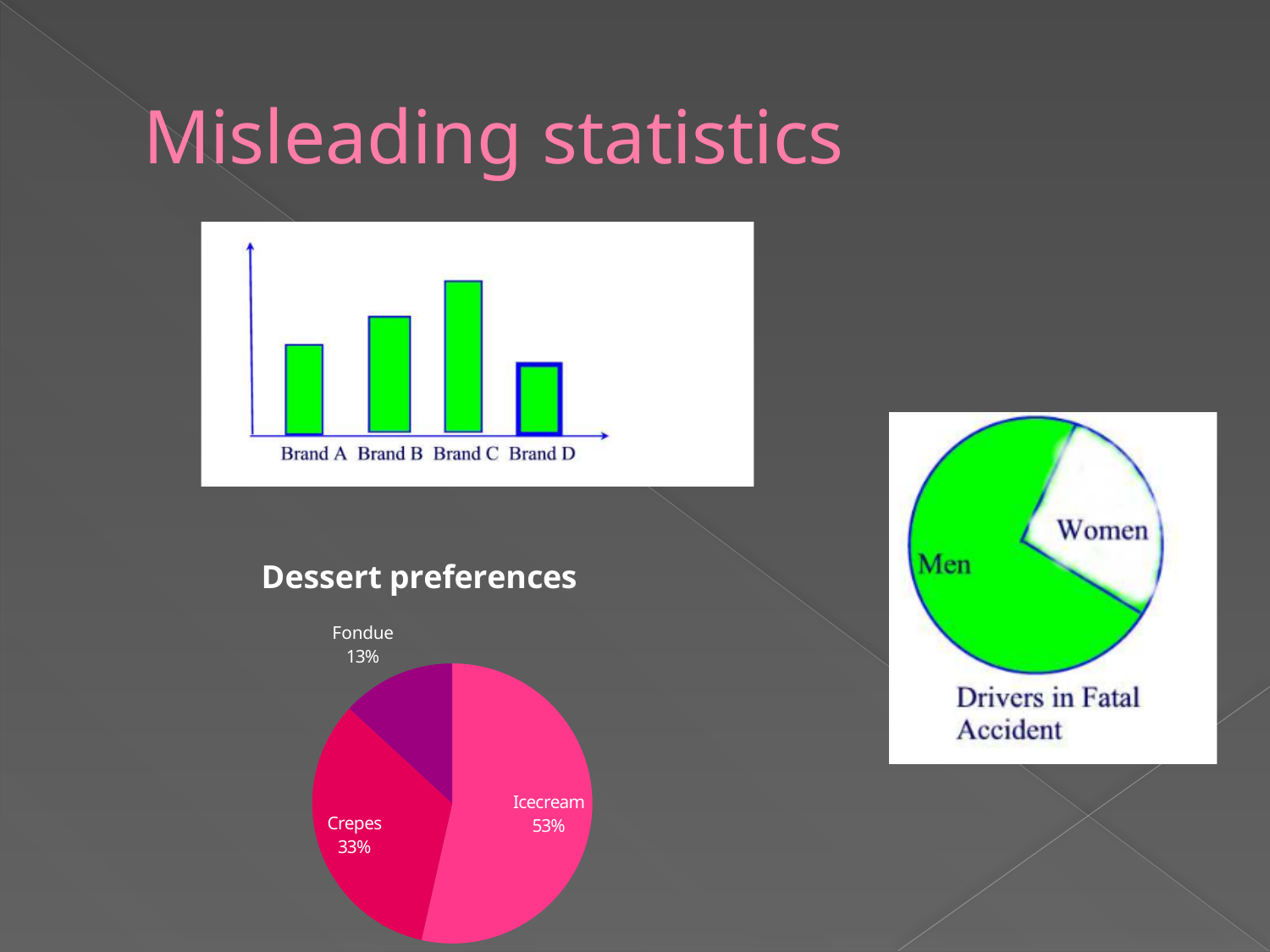
In the Dessert preferences pie chart, what share does Icecream have? 53% In the Dessert preferences pie chart, which dessert has the largest share? Icecream In the bar chart at the top left, which bar is taller, Brand A or Brand B? Brand B In the bar chart at the top left, which brand has the shortest bar? Brand D In the Dessert preferences pie chart, what share does Crepes have? 33% In the bar chart at the top left, how many brands are shown? 4 In the Dessert preferences pie chart, what share does Fondue have? 13% In the Drivers in Fatal Accident pie chart, which group has the larger slice? Men In the Dessert preferences pie chart, which dessert has the smallest share? Fondue In the bar chart at the top left, which brand has the tallest bar? Brand C In the Dessert preferences pie chart, what is the difference between the Icecream and Crepes shares? 20% In the Dessert preferences pie chart, how many slices are there? 3